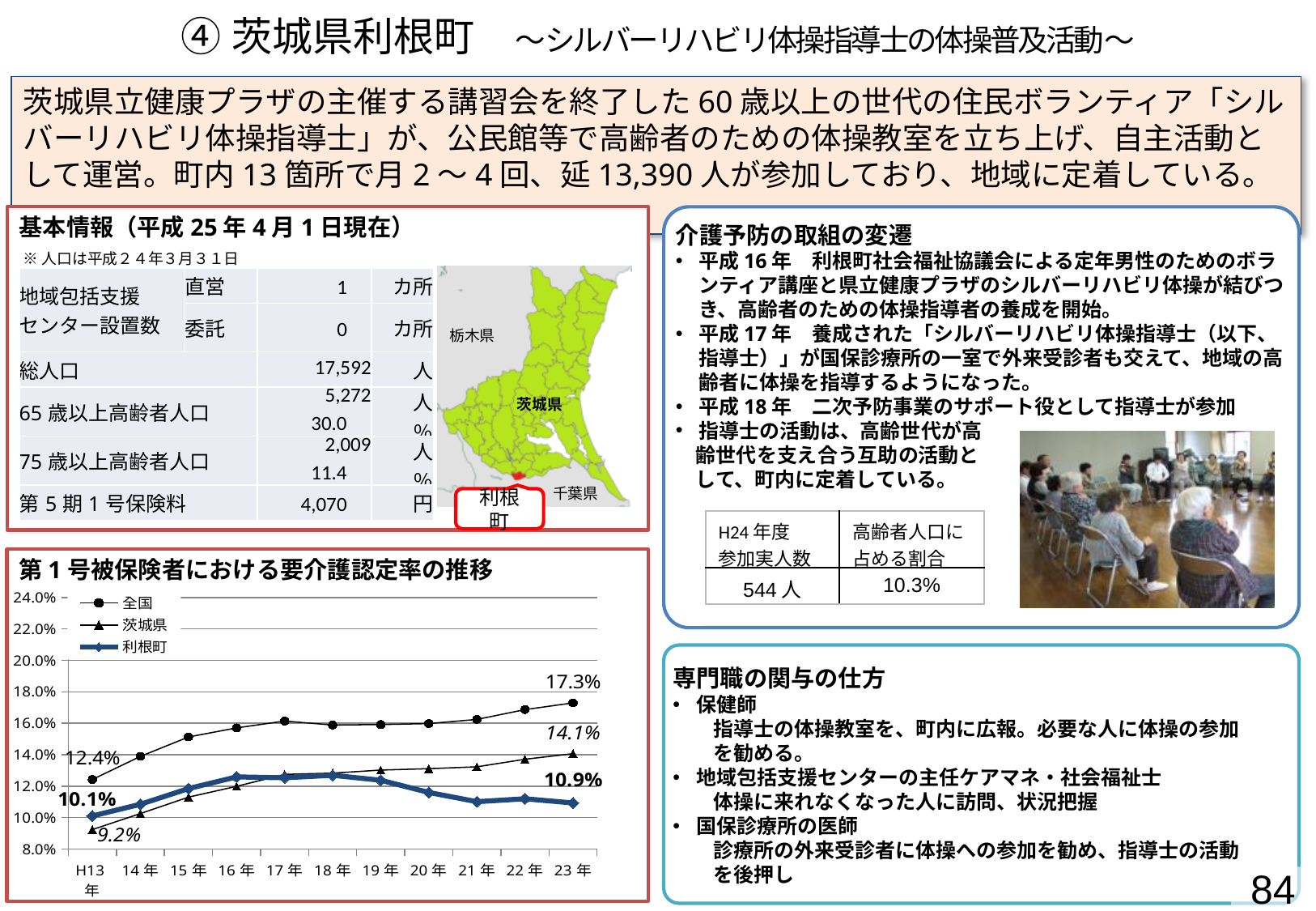
What kind of chart is the chart titled 第1号被保険者における要介護認定率の推移? Line chart How many series does the legend of the 要介護認定率の推移 chart list? 3 In the 要介護認定率の推移 chart, what is the difference between the 全国 and 利根町 values in 23年? 6.4 percentage points In the 要介護認定率の推移 chart, what is the value for 茨城県 in H13年? 9.2% In the 要介護認定率の推移 chart, which series has the highest value in 23年? 全国 In the 要介護認定率の推移 chart, what is the value for 茨城県 in 23年? 14.1% In the 要介護認定率の推移 chart, what is the value for 全国 in 23年? 17.3% In the 要介護認定率の推移 chart, is the value for 全国 in 17年 greater or less than 14.0%? greater How many years are plotted along the x axis of the 要介護認定率の推移 chart? 11 In the 要介護認定率の推移 chart, what is the value for 利根町 in 23年? 10.9% In the 要介護認定率の推移 chart, does the 全国 series rise or fall from H13年 to 23年? Rise In the 要介護認定率の推移 chart, what is the value for 全国 in H13年? 12.4%